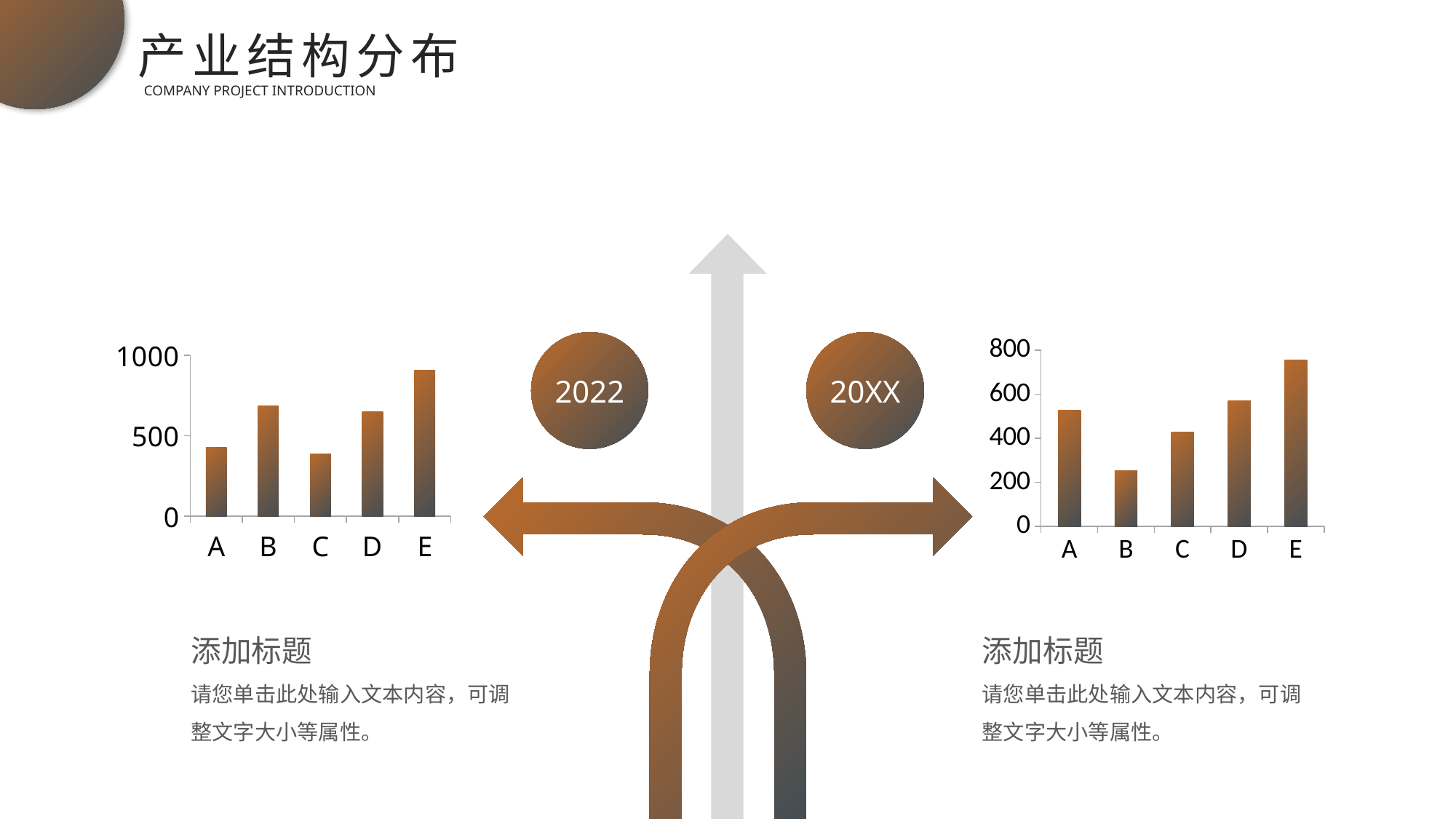
In the right chart (20XX), which category has the lowest value? B What kind of chart is the left chart (labelled 2022)? bar chart In the left chart (2022), is the value for C greater or less than 500? less In the left chart (2022), is the value for B greater or less than 500? greater How many categories does the right chart (labelled 20XX) show? 5 In the right chart (20XX), is the value for E greater or less than 600? greater In the left chart (2022), which is larger, the value for B or the value for C? B In the right chart (20XX), which is larger, the value for A or the value for B? A In the left chart (2022), which category has the highest value? E In the right chart (20XX), which category has the highest value? E